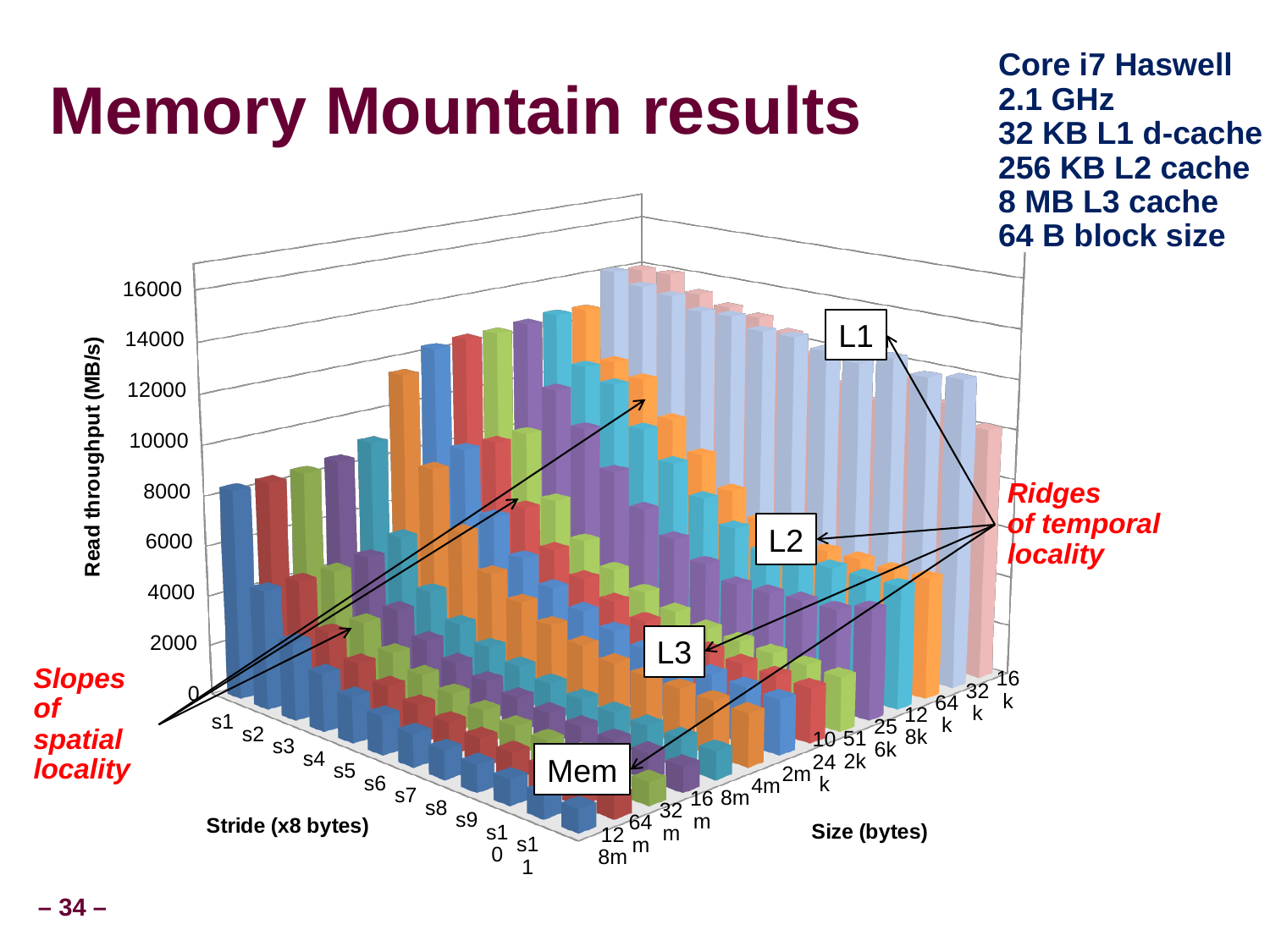
For the same size, which has the larger read throughput: stride s1 or stride s11? s1 What is the label of the vertical axis of the chart? Read throughput (MB/s) What kind of chart is shown on the slide? 3D bar chart For the 16k size, is the read throughput at stride s1 greater or less than 12000 MB/s? greater What is the highest tick value shown on the vertical axis? 16000 How many stride categories (s1 through s11) are shown along the stride axis? 11 Which labelled region of the chart (L1, L2, L3 or Mem) has the lowest read throughput? Mem For a given working-set size, does read throughput rise or fall as the stride increases from s1 to s11? fall For the 128m size, is the read throughput at stride s11 greater or less than 2000 MB/s? less Which labelled region of the chart (L1, L2, L3 or Mem) has the highest read throughput? L1 Which stride value gives the highest read throughput for a given size? s1